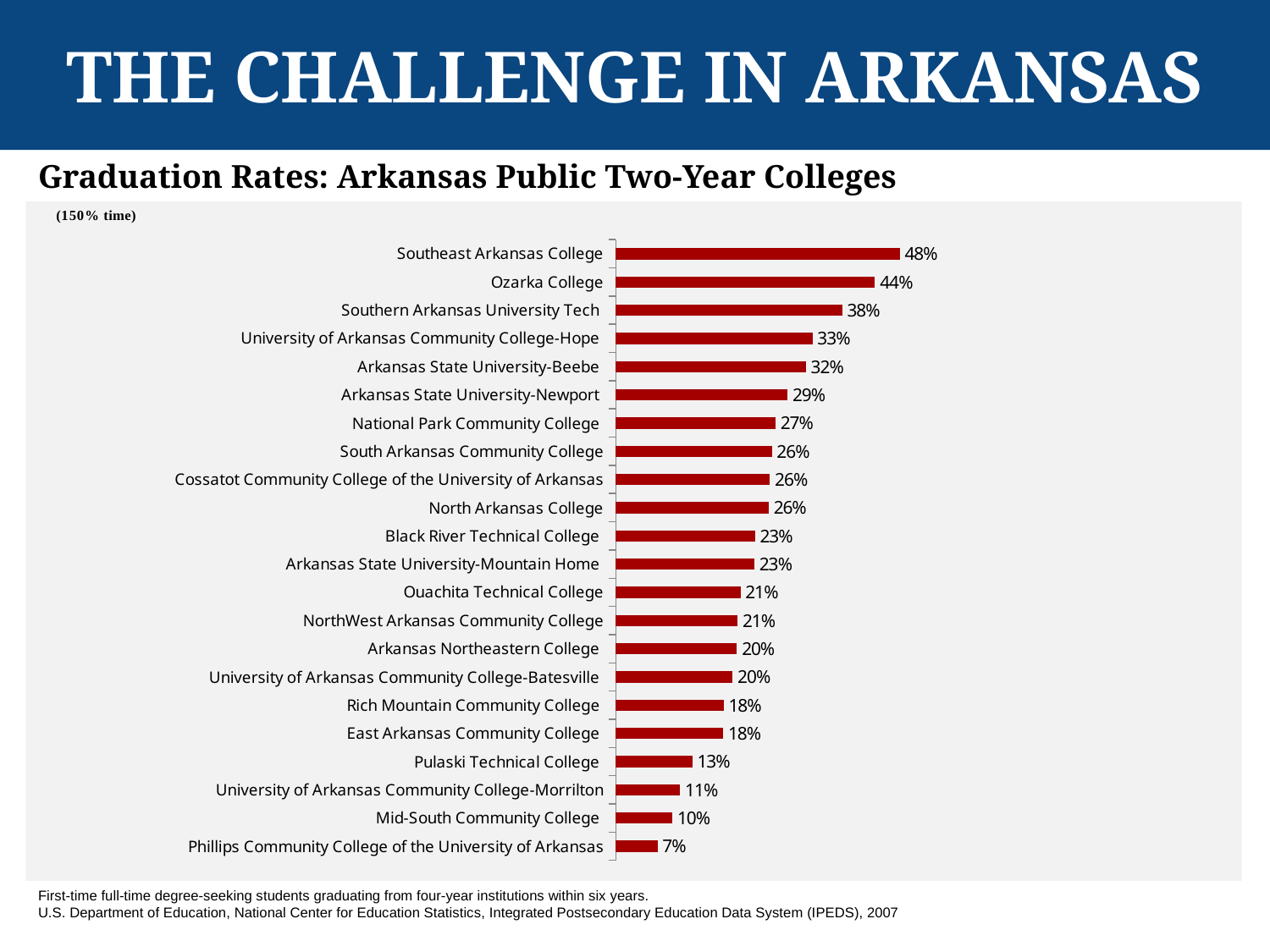
What is the title of the chart? Graduation Rates: Arkansas Public Two-Year Colleges Which college has the lowest graduation rate? Phillips Community College of the University of Arkansas What is the graduation rate for Arkansas State University-Beebe? 32% What is the graduation rate for Ozarka College? 44% Which has a higher graduation rate, University of Arkansas Community College-Morrilton or Rich Mountain Community College? Rich Mountain Community College Which college has the highest graduation rate? Southeast Arkansas College How many colleges are shown in the chart? 22 What is the difference between the graduation rates of Southeast Arkansas College and Ozarka College? 4% What is the difference between the graduation rates of Southern Arkansas University Tech and Mid-South Community College? 28% What kind of chart is shown on the slide? Bar chart What is the graduation rate for Pulaski Technical College? 13% Which has a higher graduation rate, National Park Community College or Black River Technical College? National Park Community College